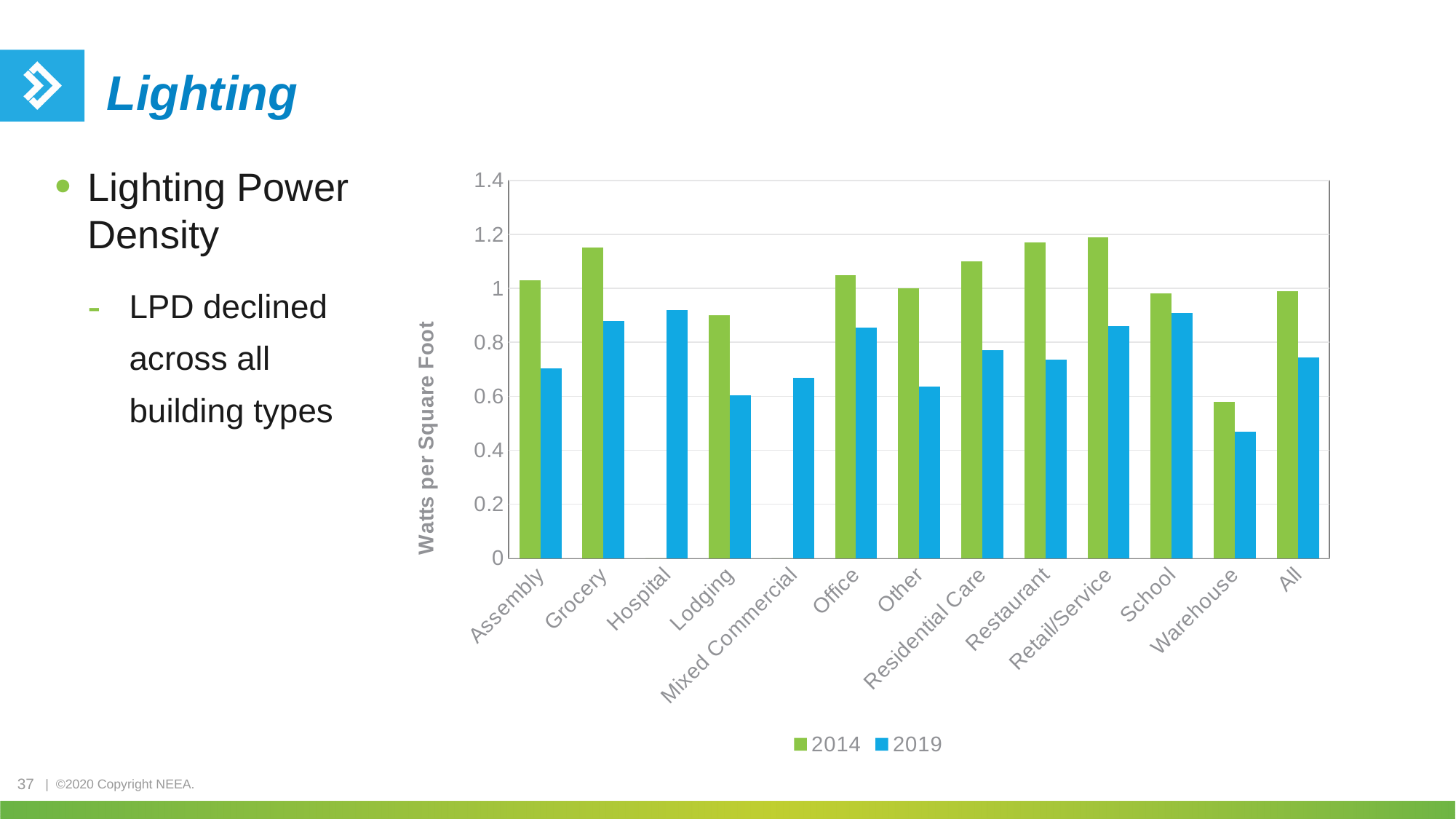
For Grocery, which series has the larger value, 2014 or 2019? 2014 What kind of chart is shown on the slide? bar chart How many building-type categories are shown on the x axis of the chart? 13 Is the 2019 value for Lodging greater or less than 0.8? less Which has the larger 2014 value, Office or Warehouse? Office What is the label on the vertical axis of the chart? Watts per Square Foot Which category has the lowest 2019 value in the chart? Warehouse How many series does the chart legend list? 2 Is the 2014 value for Grocery greater or less than 1? greater Is the 2019 value for Warehouse greater or less than 0.6? less Which category has the lowest 2014 value in the chart? Warehouse